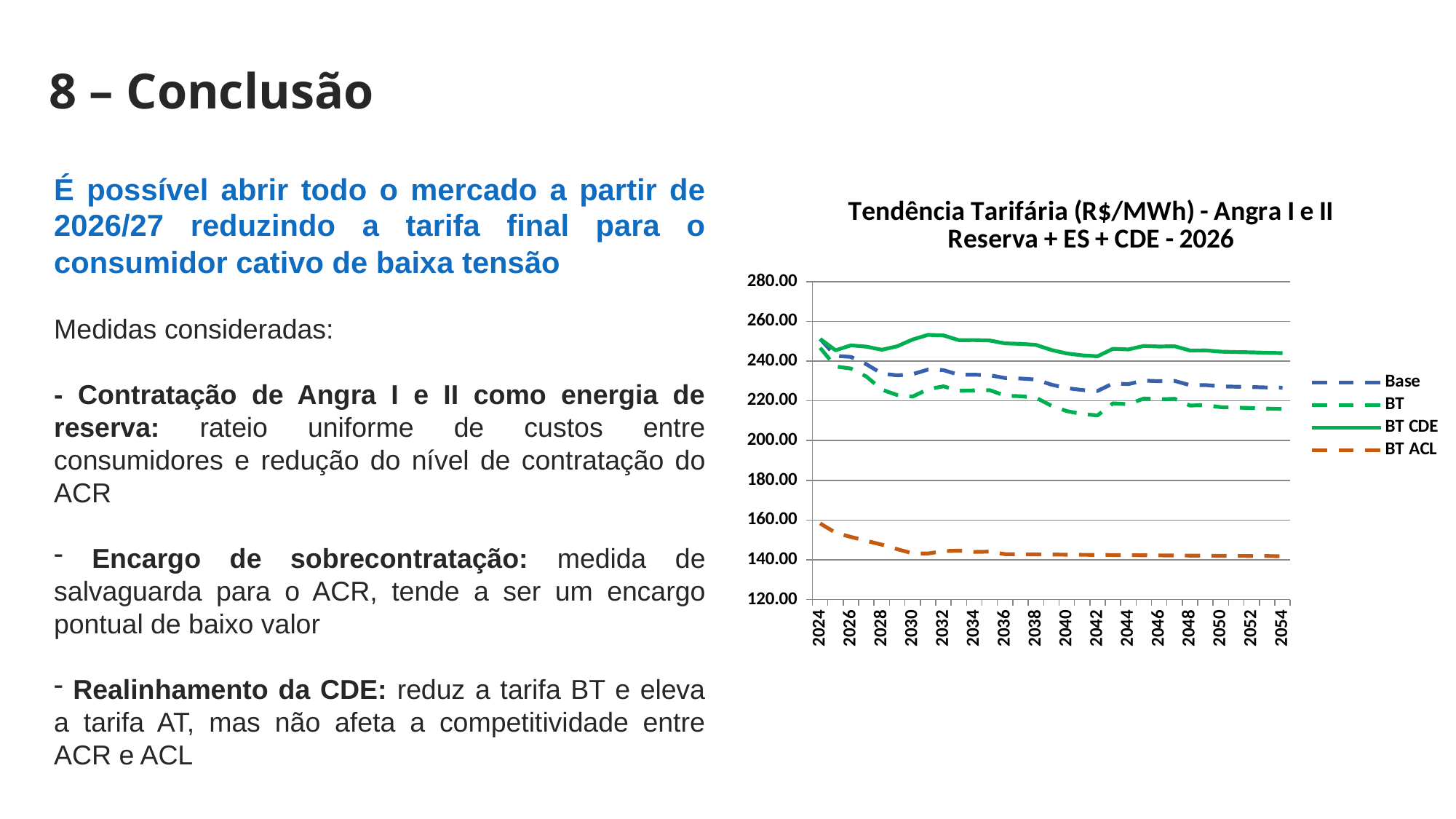
Is the value for BT ACL in 2040 greater or less than 160? less In 2040, which series has the larger value, BT CDE or BT ACL? BT CDE Is the value for BT CDE in 2032 greater or less than 240? greater In 2042, which series has the larger value, Base or BT? Base What is the title of the chart? Tendência Tarifária (R$/MWh) - Angra I e II Reserva + ES + CDE - 2026 Does the BT ACL series rise or fall from 2024 to 2054? fall What kind of chart is shown on the slide? line chart How many series does the legend of the chart list? 4 Which series has the highest values across most of the period in the chart? BT CDE Is the value for Base in 2054 greater or less than 240? less Which series has the lowest values across the whole period in the chart? BT ACL Which series is drawn with an orange dashed line? BT ACL